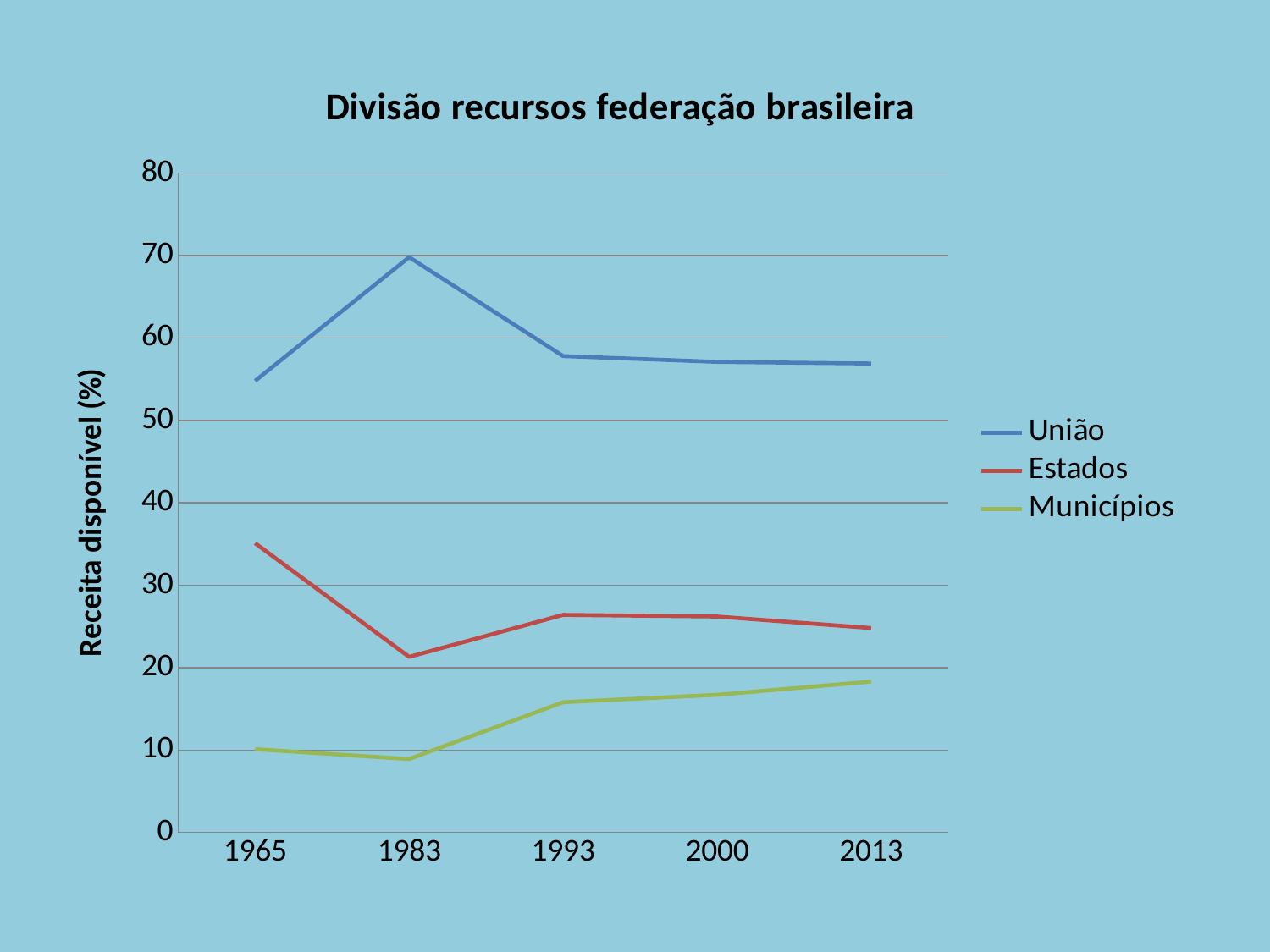
Is the value for Estados in 1983 greater or less than 30? less Does the Municípios series rise or fall between 1983 and 2013? rise What kind of chart is shown on the slide? line chart Is the value for Municípios in 2013 greater or less than 20? less Which series has the highest value in 1983? União How many years are shown on the x axis? 5 In which year does the Estados series reach its lowest value? 1983 How many series does the legend list? 3 In which year does the União series reach its highest value? 1983 Which series has the lowest value in 1965? Municípios Which is larger in 1965, the value for Estados or the value for Municípios? Estados Is the value for União in 1983 greater or less than 60? greater